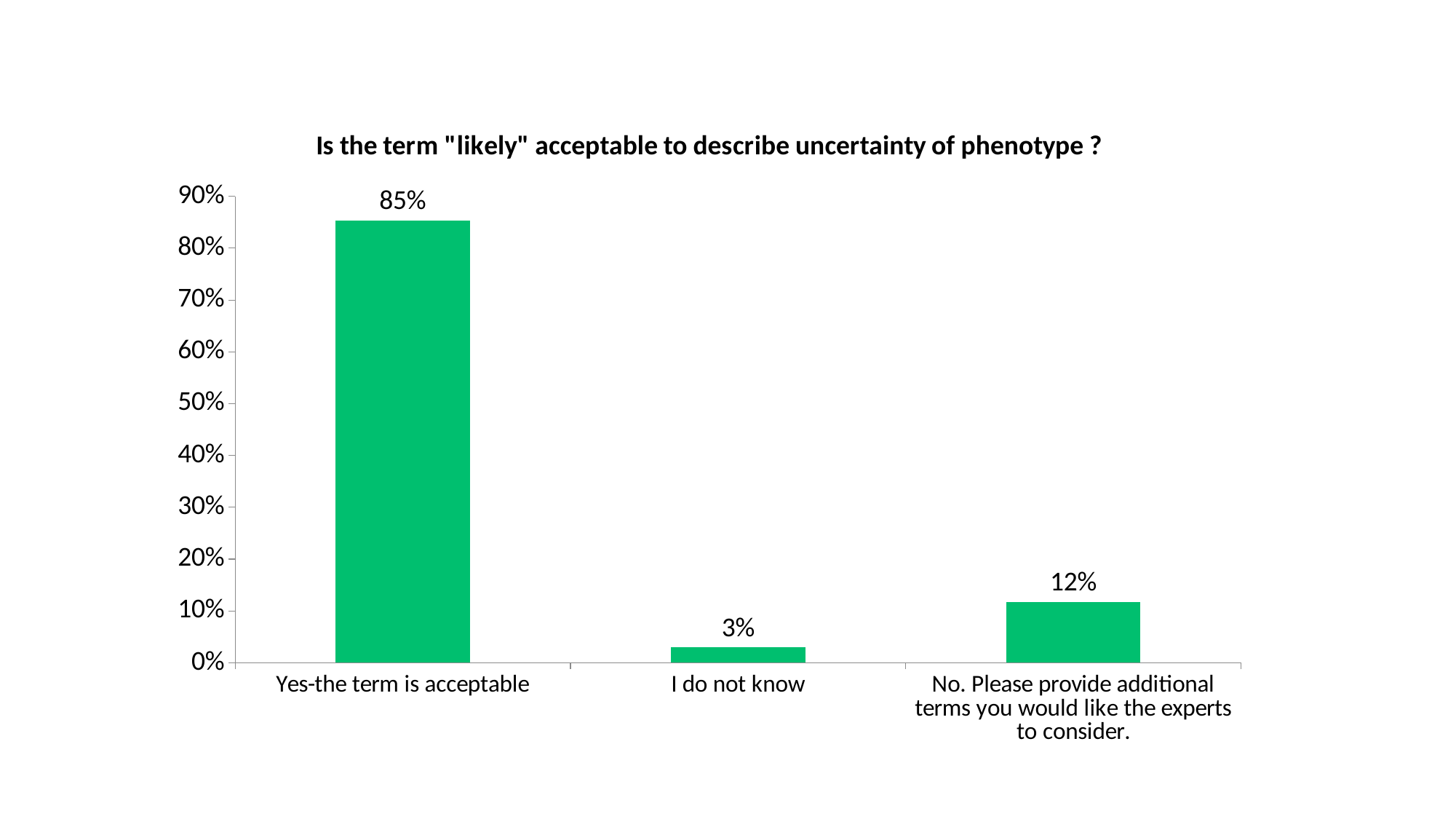
What percentage of respondents chose the "No" option? 12% What kind of chart is shown on the slide? Bar chart Which response category has the highest value? Yes-the term is acceptable Which is larger, the value for "I do not know" or the value for "No"? No What is the difference between the "No" value and the "I do not know" value? 9% Which response category has the lowest value? I do not know What percentage of respondents answered "Yes-the term is acceptable"? 85% What is the title of the chart? Is the term "likely" acceptable to describe uncertainty of phenotype ? What is the difference between the "Yes-the term is acceptable" value and the "No" value? 73% Is the value for "Yes-the term is acceptable" greater or less than 80%? greater How many response categories are shown on the chart? 3 What percentage of respondents answered "I do not know"? 3%